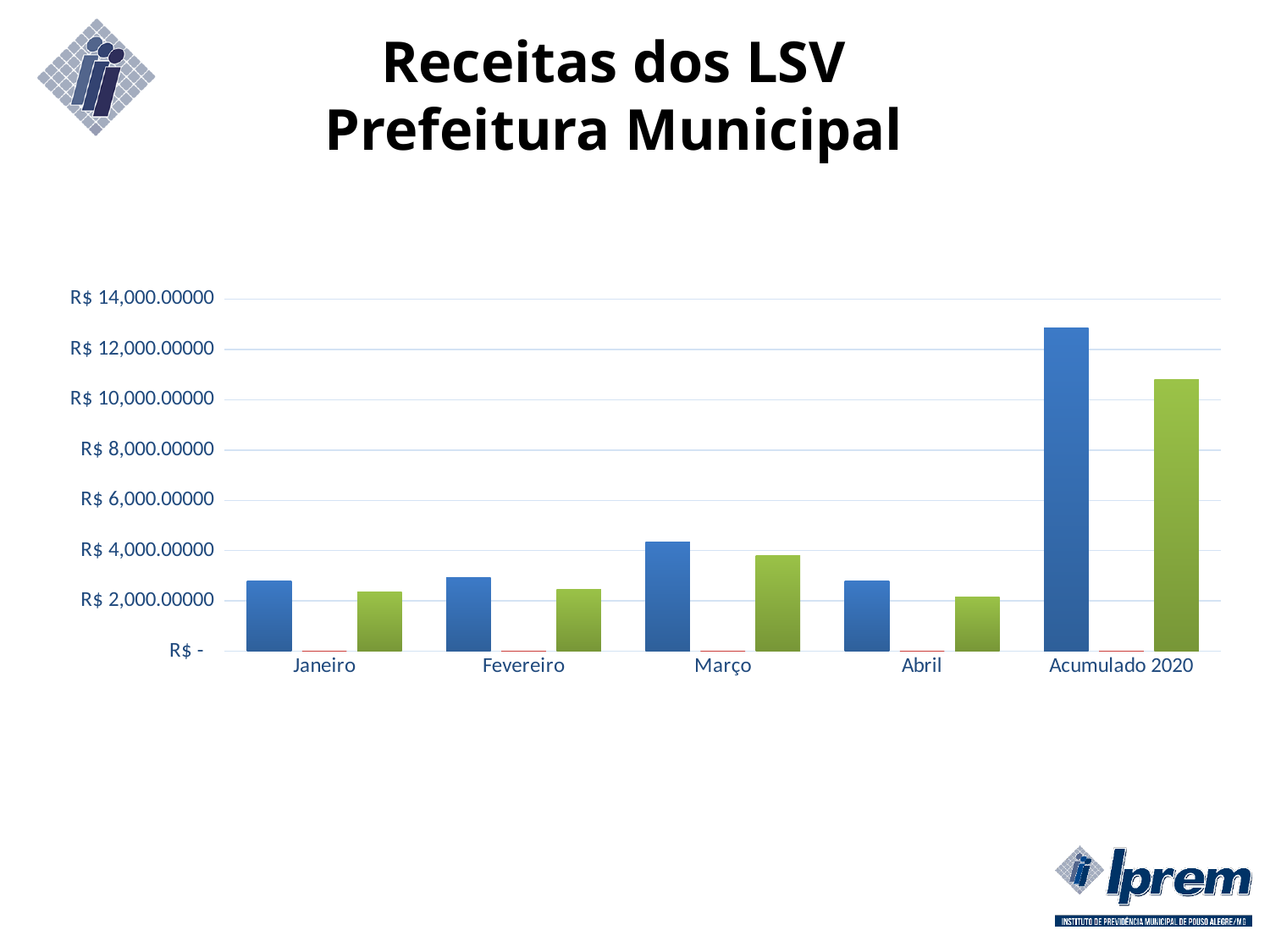
Is the green bar for Fevereiro greater or less than R$ 2,000.00000? greater Is the blue bar for Acumulado 2020 greater or less than R$ 12,000.00000? greater Is the blue bar for Janeiro greater or less than R$ 4,000.00000? less Among the months Janeiro, Fevereiro, Março and Abril, which has the tallest blue bar? Março For Acumulado 2020, which bar is taller, the blue one or the green one? the blue one For Março, which bar is taller, the blue one or the green one? the blue one What kind of chart is shown on the slide? bar chart Which category has the tallest blue bar? Acumulado 2020 How many categories are shown along the x axis of the chart? 5 What is the title of the slide containing the chart? Receitas dos LSV Prefeitura Municipal